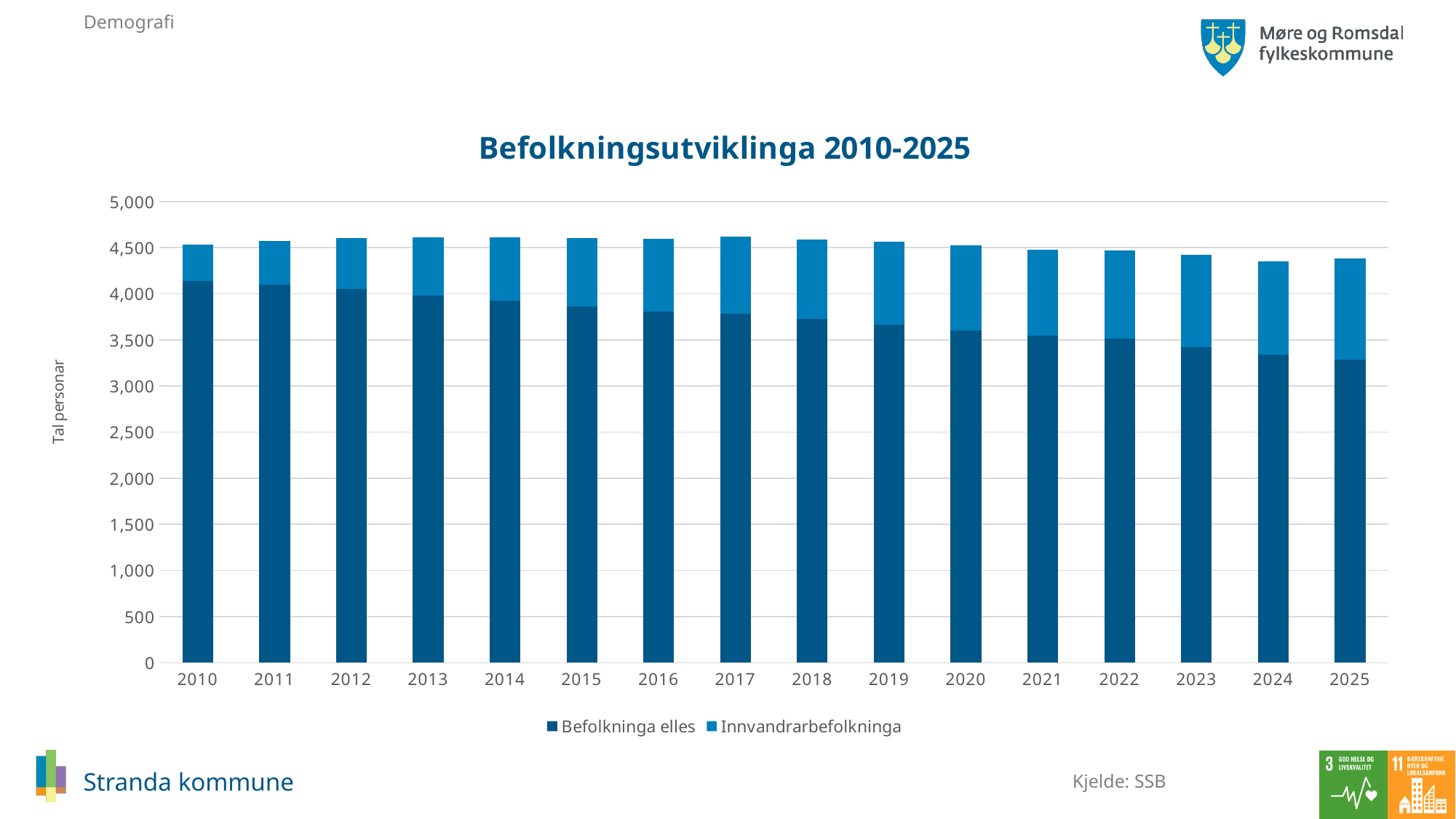
Is the total height of the stacked bar for 2025 greater or less than 4,500? less How many years are shown on the x axis? 16 Does the Innvandrarbefolkninga series rise or fall from 2010 to 2025? rise What kind of chart is shown on the slide? Stacked bar chart Is the value for Befolkninga elles in 2025 greater or less than 3,500? less Is the total height of the stacked bar for 2017 greater or less than 4,500? greater Does the Befolkninga elles series rise or fall from 2010 to 2025? fall What is the label on the vertical axis? Tal personar What is the title of the chart? Befolkningsutviklinga 2010-2025 How many series does the legend list? 2